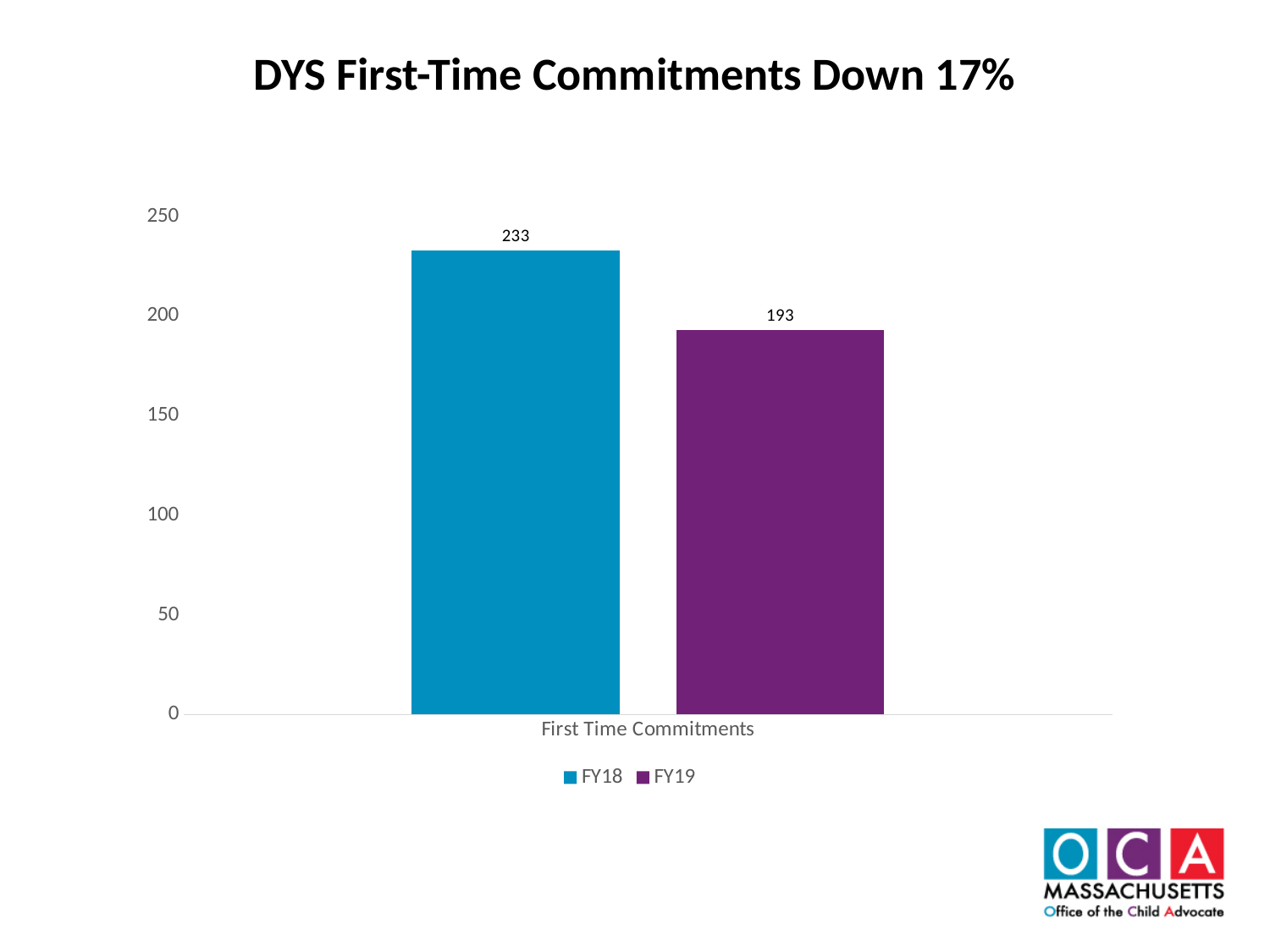
What is the value for FY19 First Time Commitments? 193 Which series has the lowest value on the chart? FY19 What is the difference between the FY18 and FY19 values for First Time Commitments? 40 What is the value for FY18 First Time Commitments? 233 How many series does the legend list? 2 Is the value for FY18 greater or less than 200? greater Which series has the higher value for First Time Commitments, FY18 or FY19? FY18 What kind of chart is shown on the slide? bar chart Is the value for FY19 greater or less than 200? less How many categories are shown on the x axis? 1 What is the title of the chart? DYS First-Time Commitments Down 17% What colour is the FY19 bar? purple